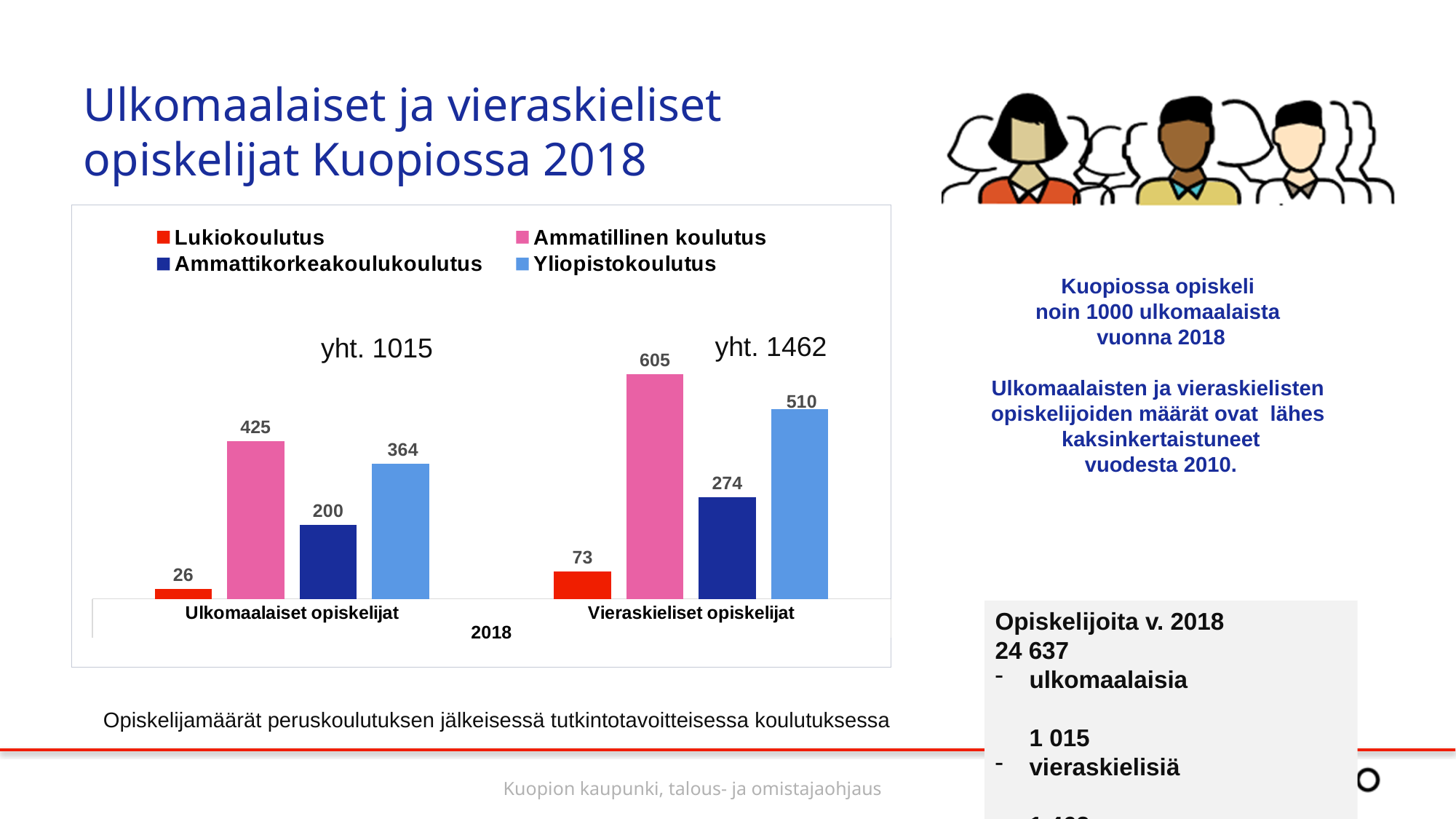
What is the value for Ammatillinen koulutus among Ulkomaalaiset opiskelijat? 425 What kind of chart is shown on the slide? Bar chart What is the value for Yliopistokoulutus among Vieraskieliset opiskelijat? 510 What is the value for Ammattikorkeakoulukoulutus among Vieraskieliset opiskelijat? 274 How many categories are shown on the x axis? 2 Which education type has the lowest value among Ulkomaalaiset opiskelijat? Lukiokoulutus What is the value for Lukiokoulutus among Ulkomaalaiset opiskelijat? 26 What is the difference between the Ammatillinen koulutus values for Vieraskieliset opiskelijat and Ulkomaalaiset opiskelijat? 180 Which is larger: Yliopistokoulutus for Ulkomaalaiset opiskelijat or Ammattikorkeakoulukoulutus for Vieraskieliset opiskelijat? Yliopistokoulutus for Ulkomaalaiset opiskelijat How many series does the legend list? 4 What total (yht.) is shown for Vieraskieliset opiskelijat? 1462 Which education type has the highest value among Vieraskieliset opiskelijat? Ammatillinen koulutus